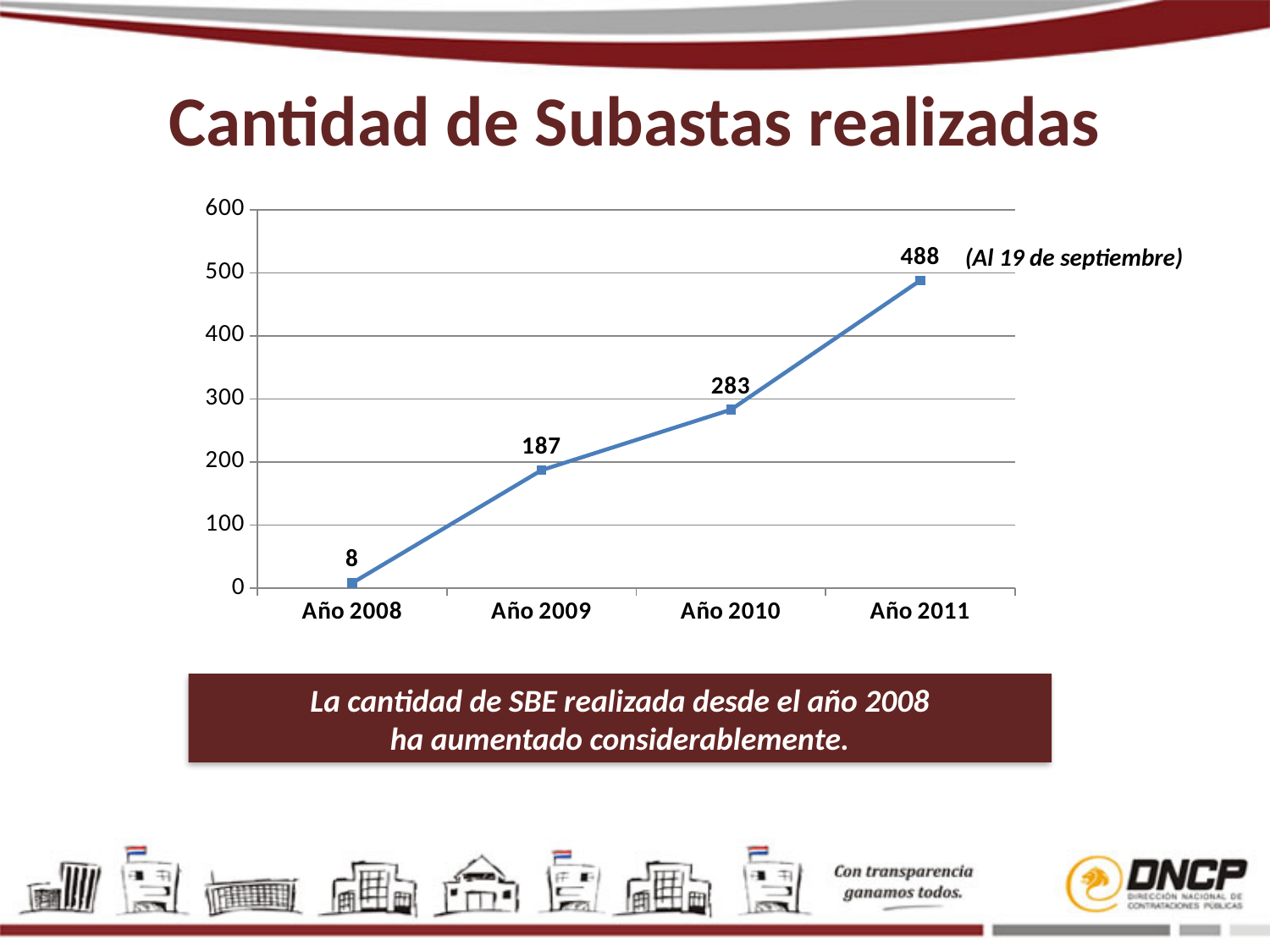
What kind of chart is shown on the slide? line chart What is the value for Año 2008? 8 How many years are plotted on the chart? 4 Which year has the highest value? Año 2011 Which year has the lowest value? Año 2008 What is the difference between the values for Año 2011 and Año 2010? 205 Which is larger, the value for Año 2010 or the value for Año 2009? Año 2010 What is the value for Año 2009? 187 Do the values rise or fall from Año 2008 to Año 2011? rise What is the value for Año 2010? 283 What is the value for Año 2011? 488 What is the difference between the values for Año 2009 and Año 2008? 179